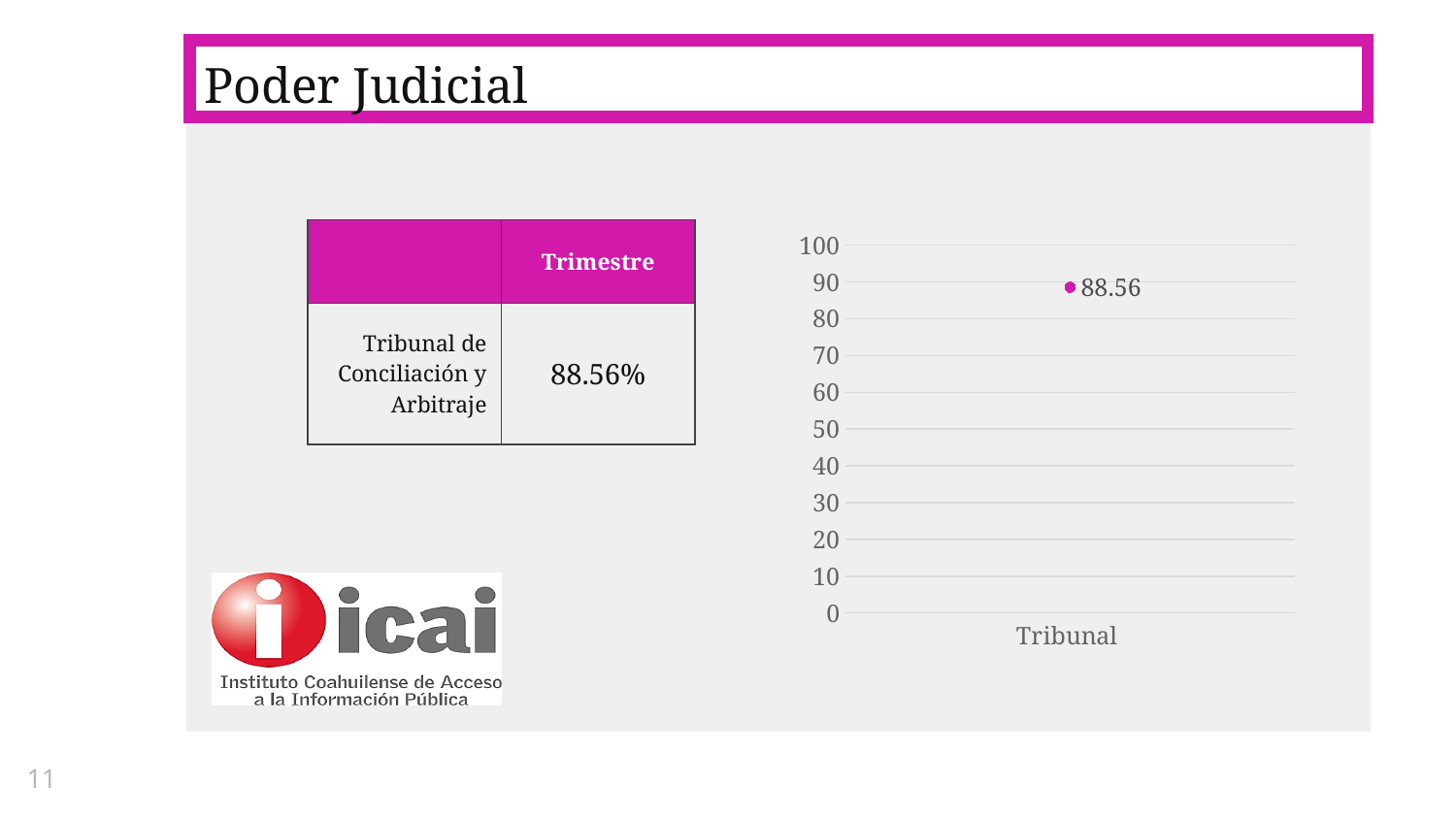
What is the value plotted for Tribunal on the chart? 88.56 Is the value for Tribunal greater or less than 80? greater How many data points are plotted on the chart? 1 Is the value for Tribunal greater or less than 90? less What is the category label shown on the x axis of the chart? Tribunal What is the maximum value shown on the chart's y axis? 100 What is the title of the slide containing the chart? Poder Judicial